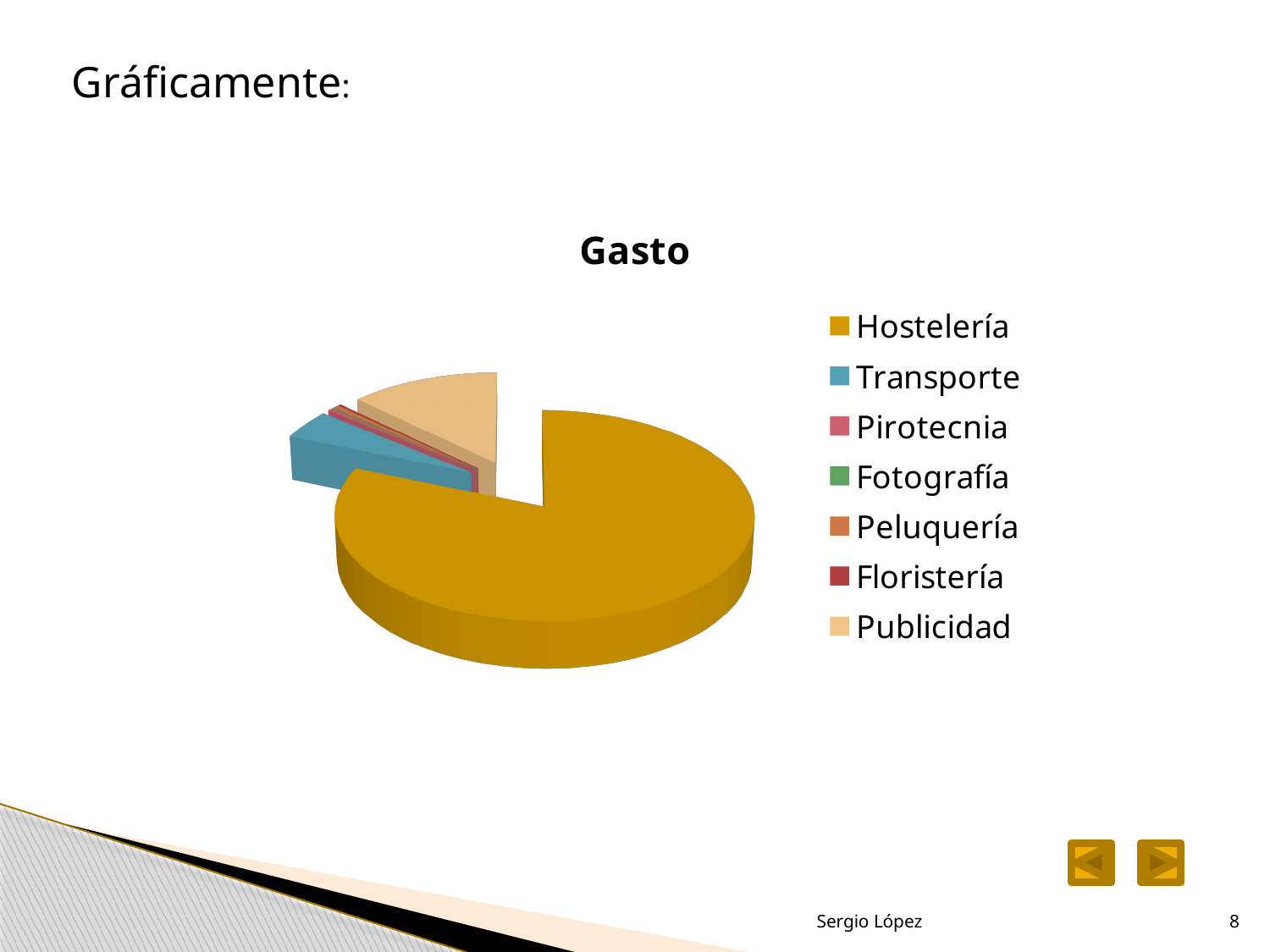
Which category is listed last in the legend? Publicidad What is the title of the chart? Gasto How many categories does the pie chart's legend list? 7 What colour is used for the Hostelería slice? Gold Which category is listed first in the legend? Hostelería Which is larger, the slice for Publicidad or the slice for Pirotecnia? Publicidad Which is larger, the slice for Hostelería or the slice for Transporte? Hostelería What kind of chart is shown on the slide? Pie chart Which is larger, the slice for Hostelería or the slice for Publicidad? Hostelería Does the Hostelería slice take up more or less than half of the pie? More Which category has the largest slice of the pie? Hostelería